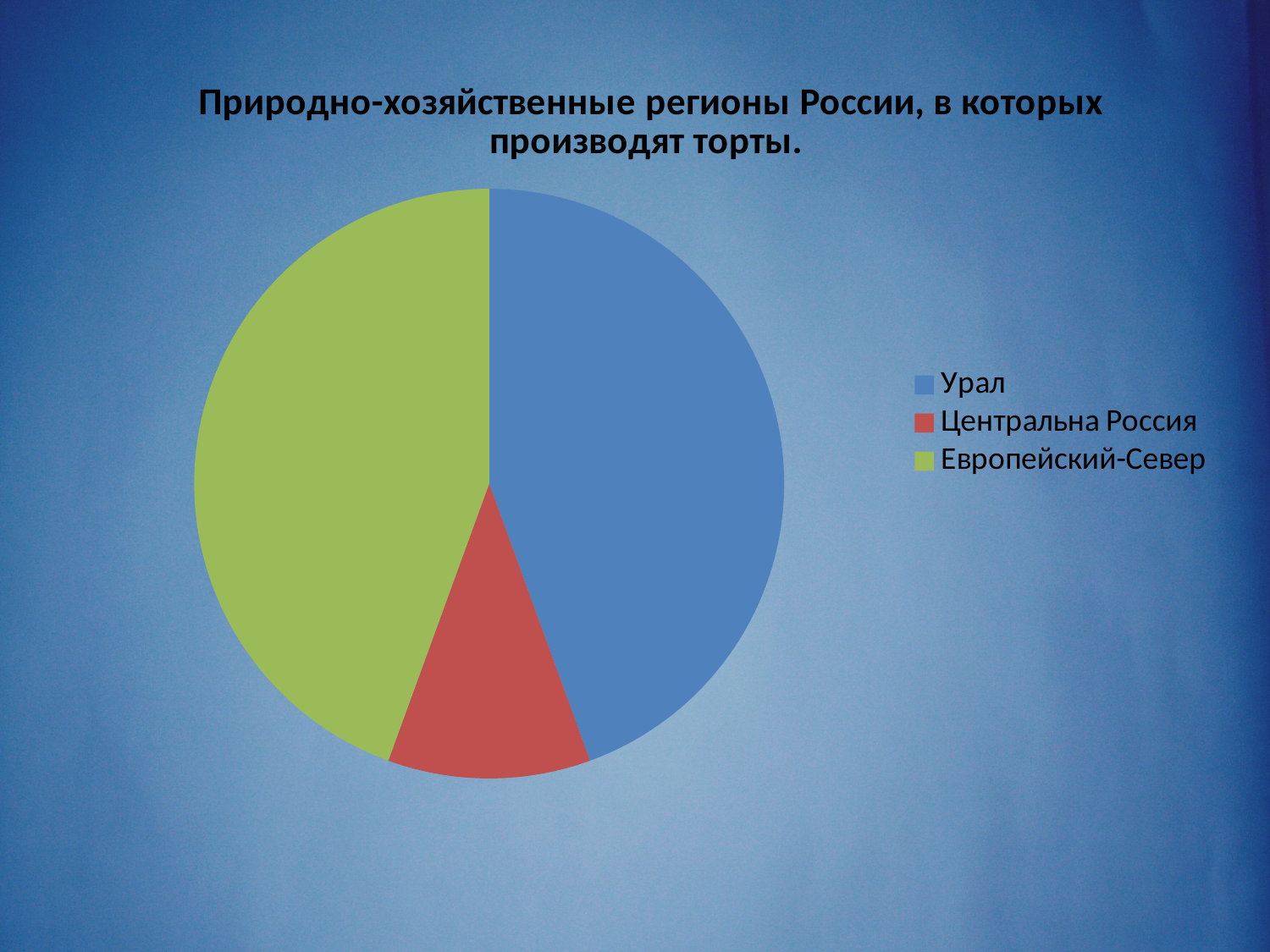
Which slice is larger: Урал or Центральна Россия? Урал What colour is the slice for Урал in the pie chart? blue What kind of chart is shown on the slide? pie chart What is the title of the pie chart? Природно-хозяйственные регионы России, в которых производят торты. How many slices does the pie chart have? 3 How many entries does the legend of the pie chart list? 3 Which slice is larger: Европейский-Север or Центральна Россия? Европейский-Север Which region has the smallest slice in the pie chart? Центральна Россия